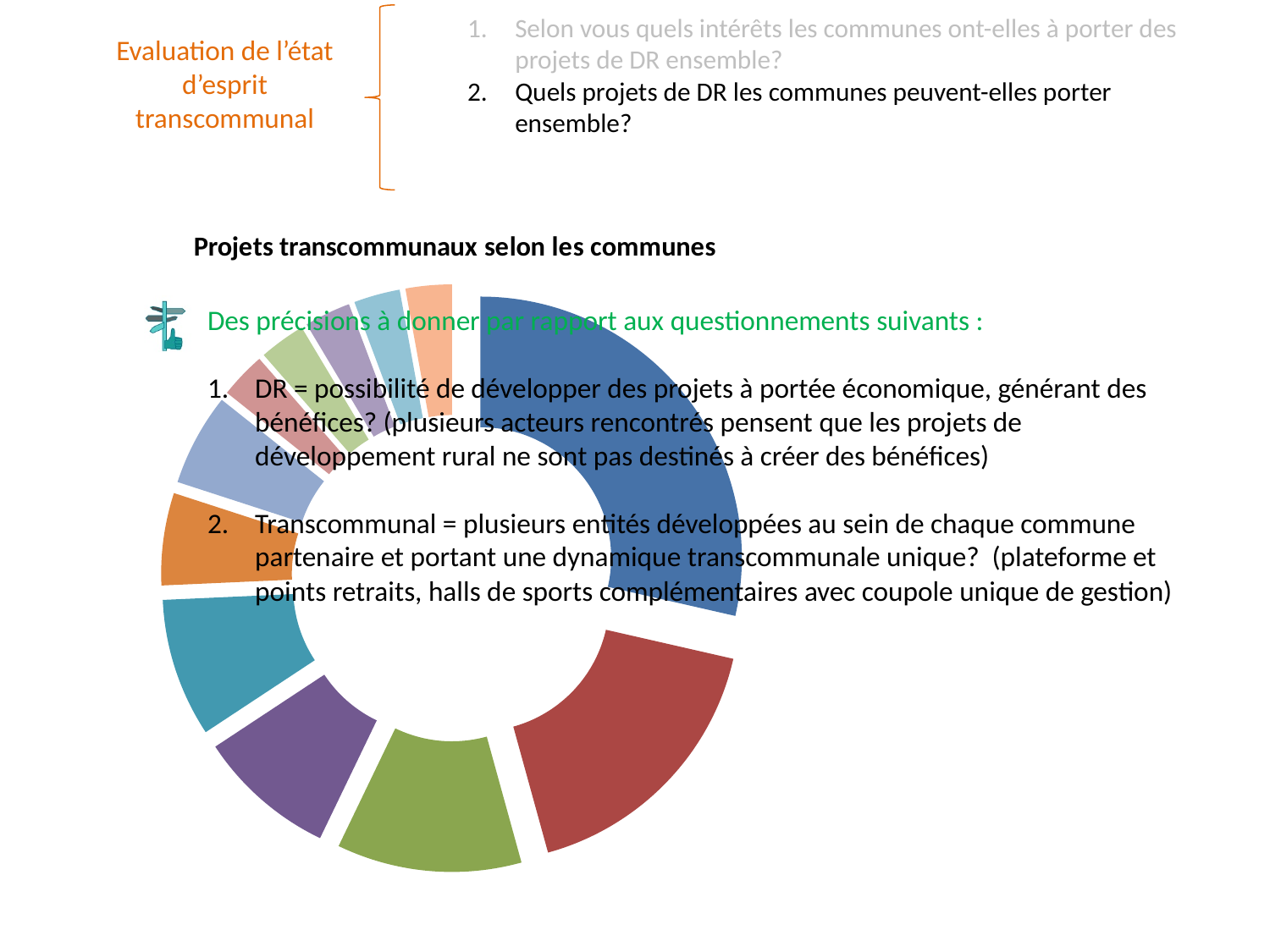
What kind of chart is shown on the slide? Doughnut chart Which is larger, the red slice or the green slice? The red slice Does the largest slice take up more or less than half of the doughnut? Less Which colour slice is the largest in the doughnut chart? The dark blue slice How many slices does the doughnut chart contain? 12 Which is larger, the dark blue slice or the red slice? The dark blue slice Does the chart display a legend? No Which is larger, the dark blue slice or the teal slice? The dark blue slice What is the title of the chart? Projets transcommunaux selon les communes